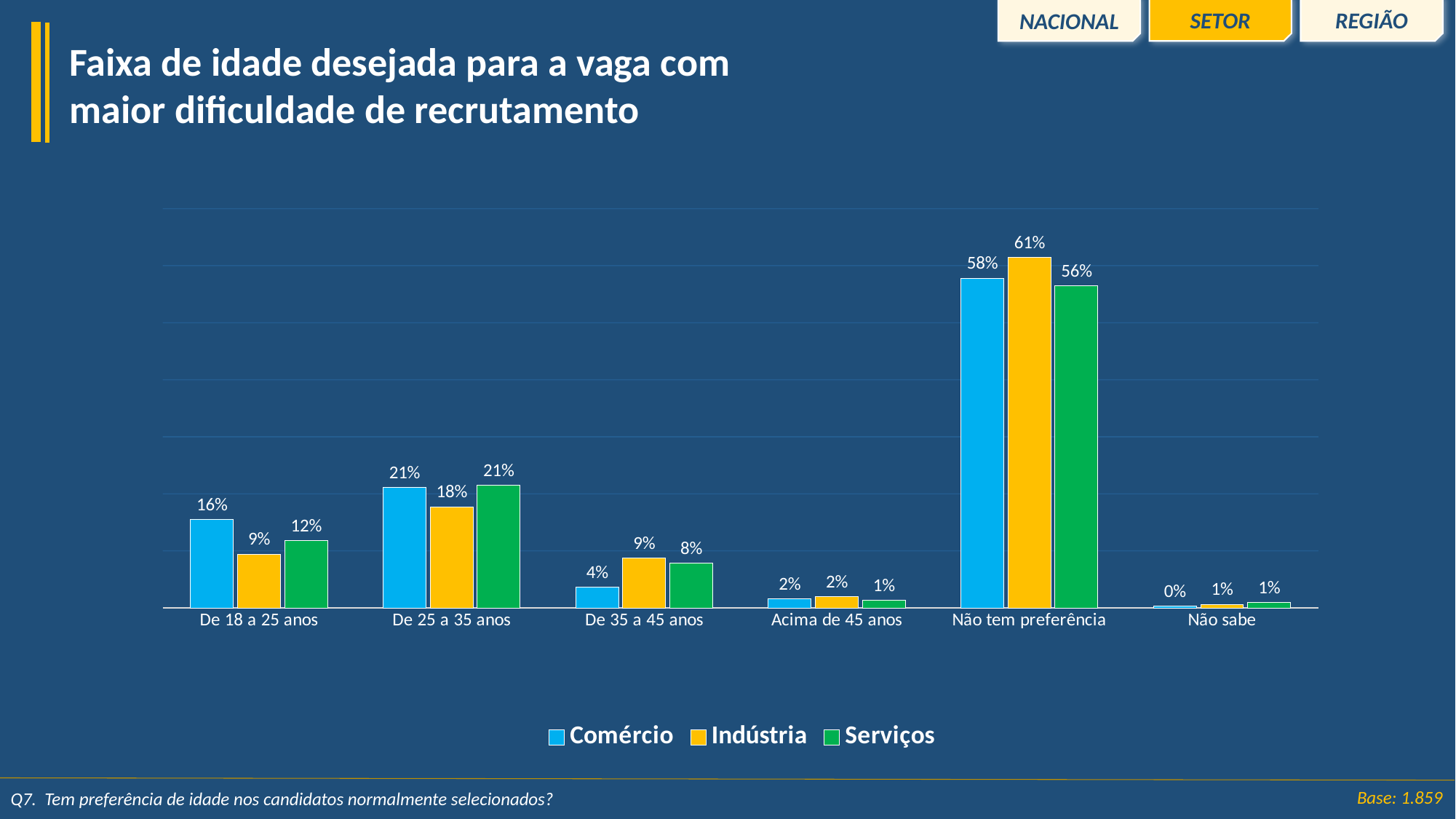
Which category has the highest value for Serviços? Não tem preferência What kind of chart is shown on the slide? Bar chart In the 'De 18 a 25 anos' category, which series has the larger value, Comércio or Serviços? Comércio What is the value for Indústria in the 'Não tem preferência' category? 61% Which series is shown in green in the legend? Serviços What is the value for Comércio in the 'De 18 a 25 anos' category? 16% What is the difference between the Comércio and Indústria values in the 'De 18 a 25 anos' category? 7% How many age categories are shown on the x axis? 6 What is the difference between the Indústria and Comércio values in the 'Não tem preferência' category? 3% Which category has the lowest value for Comércio? Não sabe How many series does the legend list? 3 What is the value for Serviços in the 'De 35 a 45 anos' category? 8%